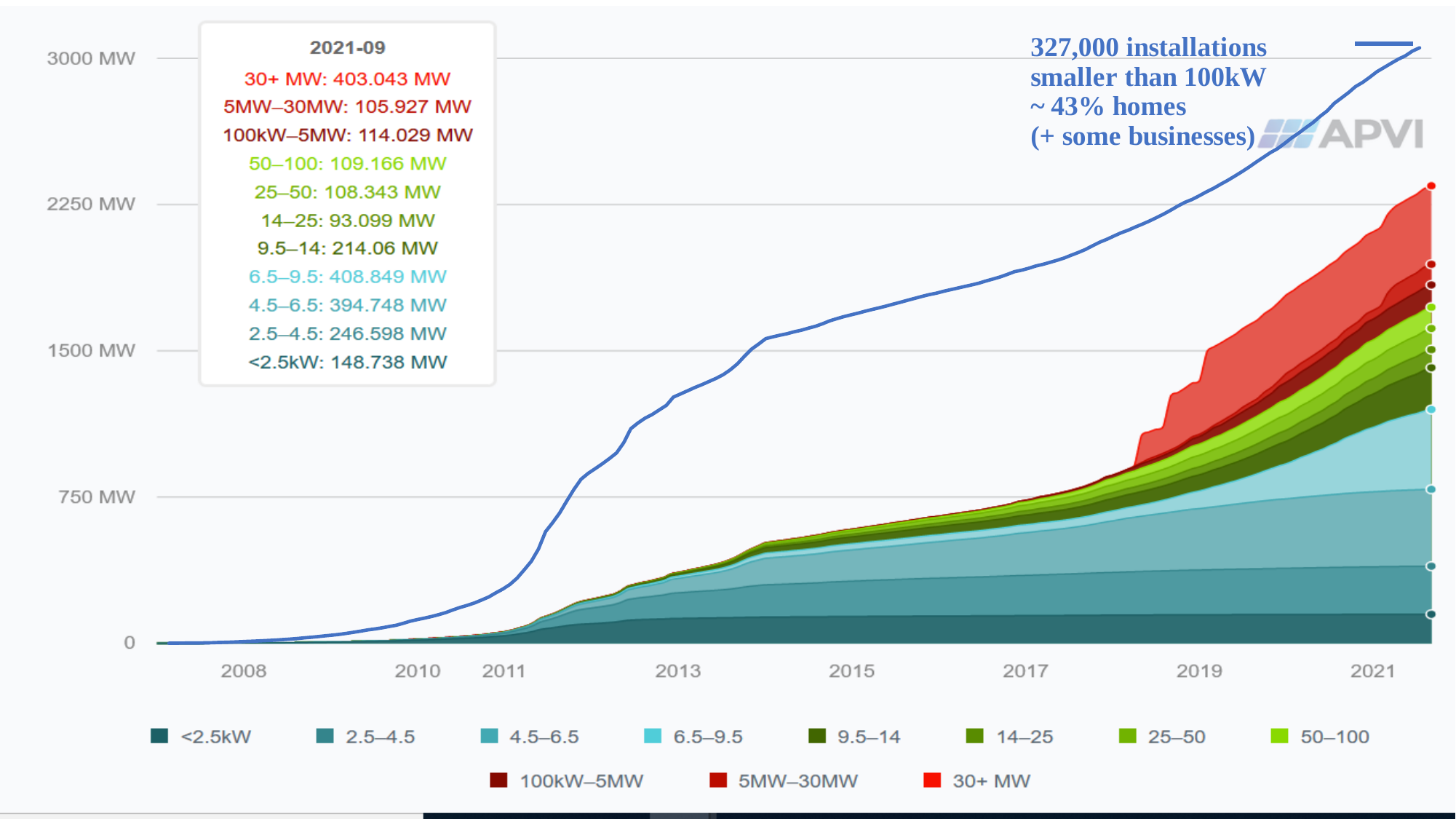
According to the tooltip for 2021-09, what is the value for the 30+ MW series? 403.043 MW Does the total installed capacity rise or fall from 2008 to 2021? Rise In the 2021-09 tooltip, what is the difference between the 6.5–9.5 value and the 4.5–6.5 value? 14.101 MW What is the date shown at the top of the tooltip box? 2021-09 In the 2021-09 tooltip, which series has the highest value? 6.5–9.5 According to the tooltip for 2021-09, what is the value for the 9.5–14 series? 214.06 MW In the 2021-09 tooltip, which is larger: the 5MW–30MW value or the 100kW–5MW value? 100kW–5MW How many series does the legend list? 11 According to the tooltip for 2021-09, what is the value for the 6.5–9.5 series? 408.849 MW In the 2021-09 tooltip, which series has the lowest value? 14–25 What kind of chart is shown on the slide? Stacked area chart According to the tooltip for 2021-09, what is the value for the <2.5kW series? 148.738 MW